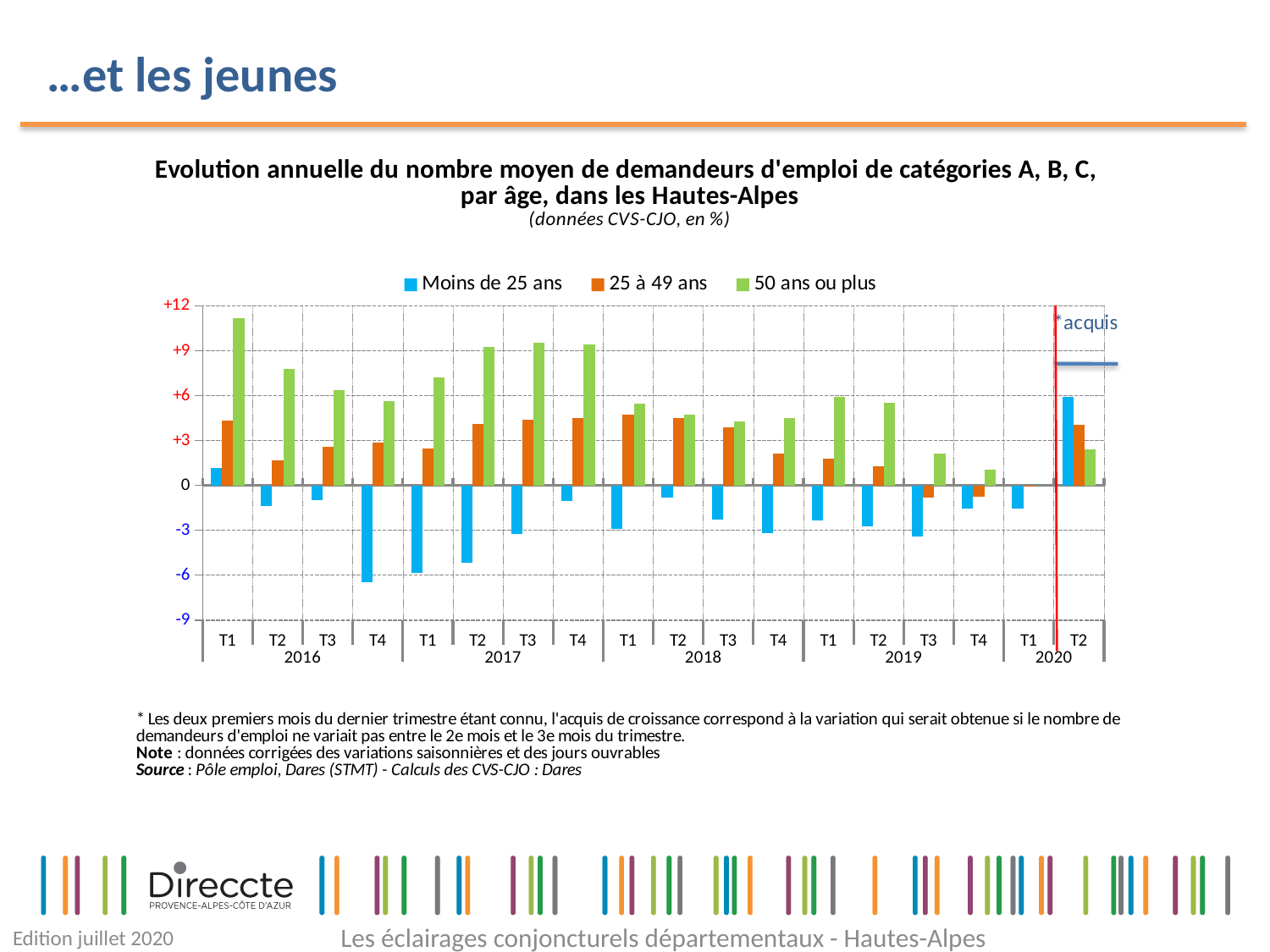
Which series is shown in blue in the legend? Moins de 25 ans How many series does the legend list? 3 Is the value for 'Moins de 25 ans' in T4 2016 greater or less than -3? less What kind of chart is shown on the slide? bar chart Is the value for '25 à 49 ans' in T3 2017 greater or less than +3? greater How many quarters are shown along the x axis? 18 Is the value for 'Moins de 25 ans' in T2 2020 greater or less than +3? greater In T2 2020, which is larger: the value for 'Moins de 25 ans' or for '50 ans ou plus'? Moins de 25 ans What label appears next to the red vertical line at the right of the chart? *acquis In T3 2017, which is larger: the value for '25 à 49 ans' or for '50 ans ou plus'? 50 ans ou plus Which quarter has the highest value for the '50 ans ou plus' series? T1 2016